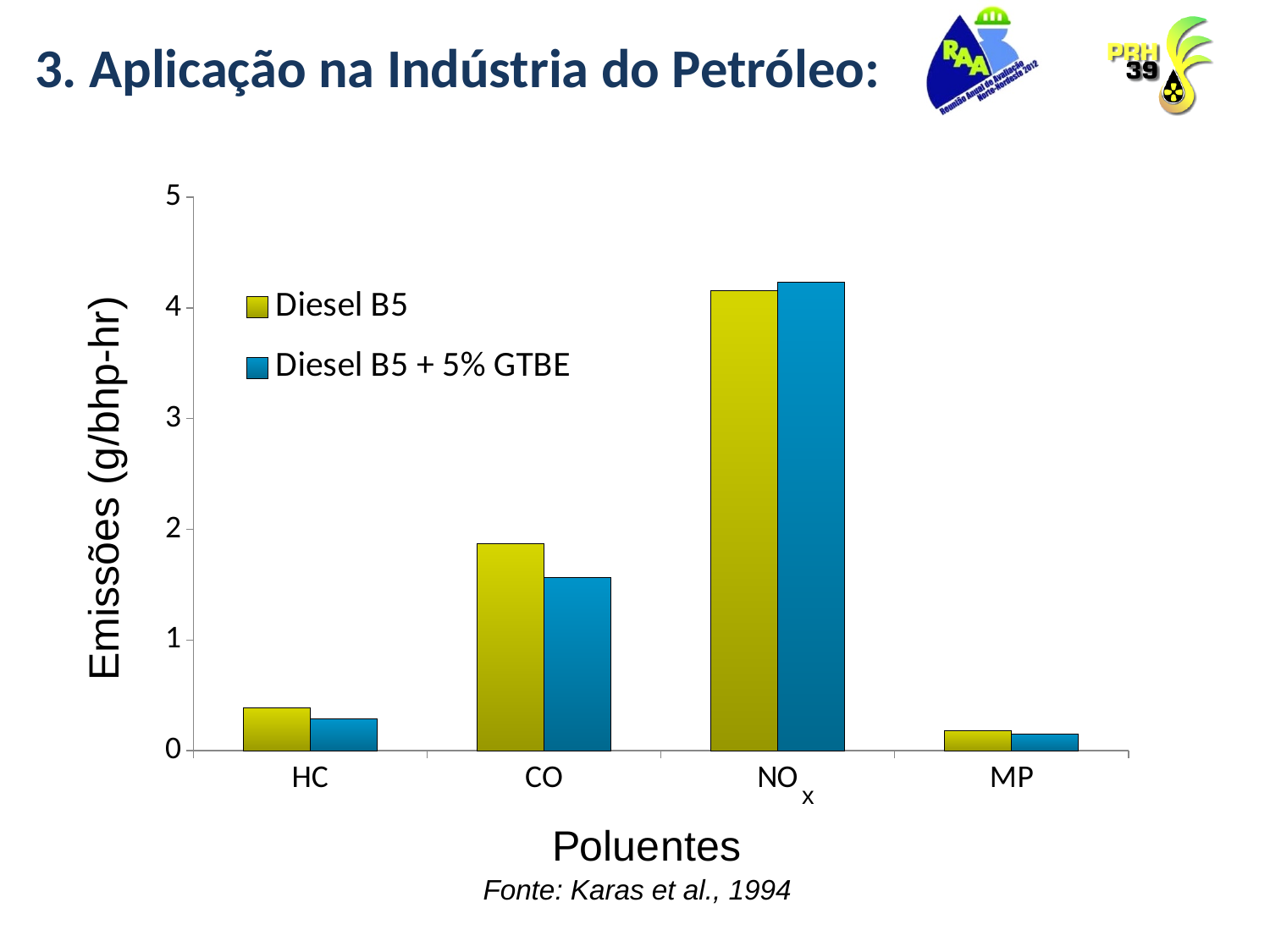
How many series does the legend list? 2 Which pollutant has the highest emissions for Diesel B5? NOx Is the value for NOx with Diesel B5 + 5% GTBE greater or less than 4? greater What is the label of the y axis? Emissões (g/bhp-hr) Is the value for CO with Diesel B5 greater or less than 1? greater For HC, which series has the larger value: Diesel B5 or Diesel B5 + 5% GTBE? Diesel B5 Which pollutant has the lowest emissions for Diesel B5 + 5% GTBE? MP How many pollutant categories are shown on the x axis? 4 Is the value for HC with Diesel B5 greater or less than 1? less What kind of chart is shown on the slide? bar chart For CO, which series has the larger value: Diesel B5 or Diesel B5 + 5% GTBE? Diesel B5 What are the two series named in the legend? Diesel B5; Diesel B5 + 5% GTBE